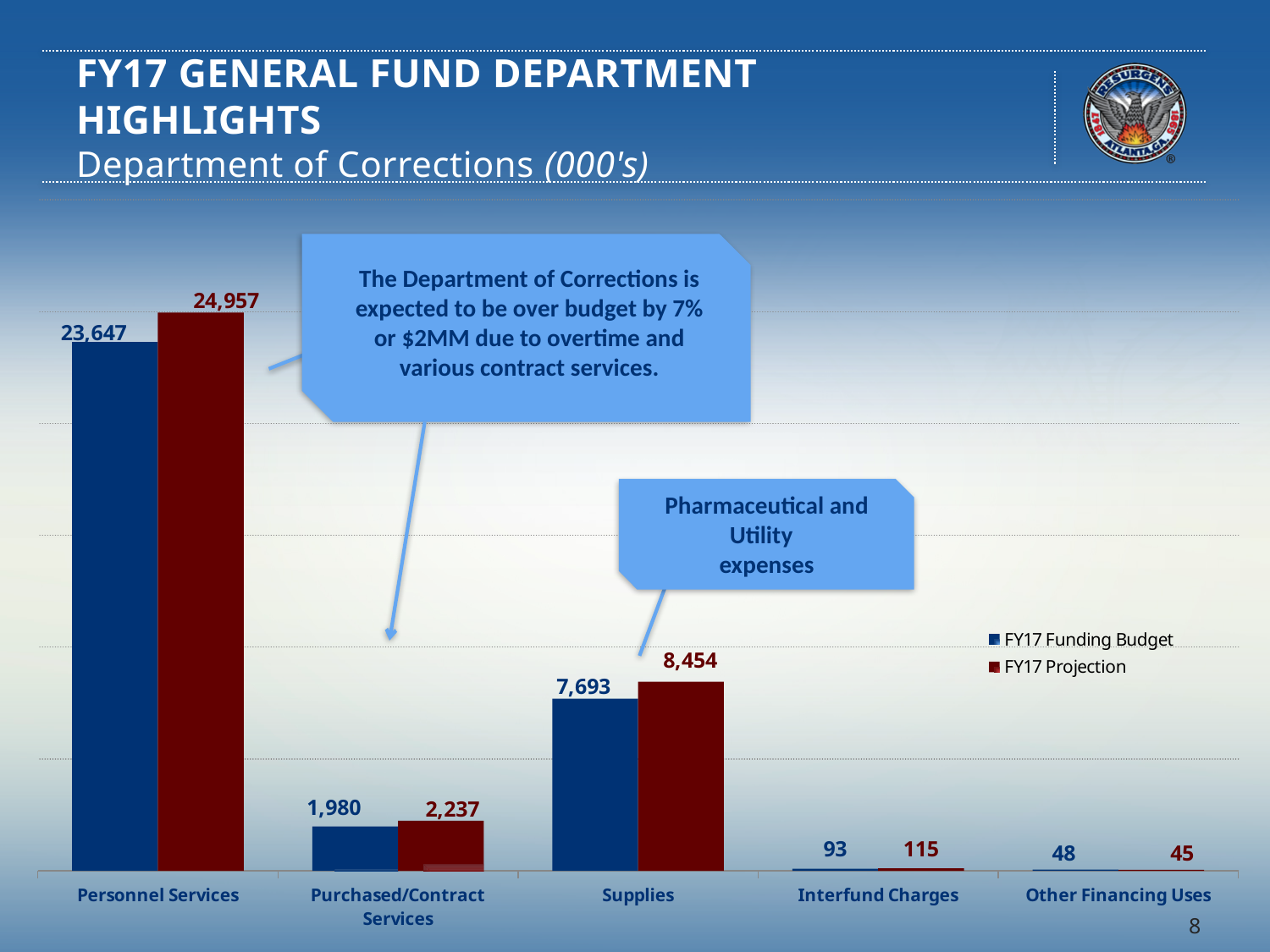
What is the FY17 Projection value for Purchased/Contract Services? 2,237 What kind of chart is shown on the slide? Bar chart What is the FY17 Funding Budget value for Personnel Services? 23,647 How many categories are shown on the x axis of the chart? 5 For Other Financing Uses, which is larger: the FY17 Funding Budget or the FY17 Projection? FY17 Funding Budget What is the FY17 Projection value for Supplies? 8,454 What is the difference between the FY17 Projection and the FY17 Funding Budget for Personnel Services? 1,310 Which category has the lowest FY17 Funding Budget value? Other Financing Uses Which category has the highest FY17 Projection value? Personnel Services What is the difference between the FY17 Projection and the FY17 Funding Budget for Supplies? 761 What is the FY17 Funding Budget value for Interfund Charges? 93 How many series does the chart legend list? 2